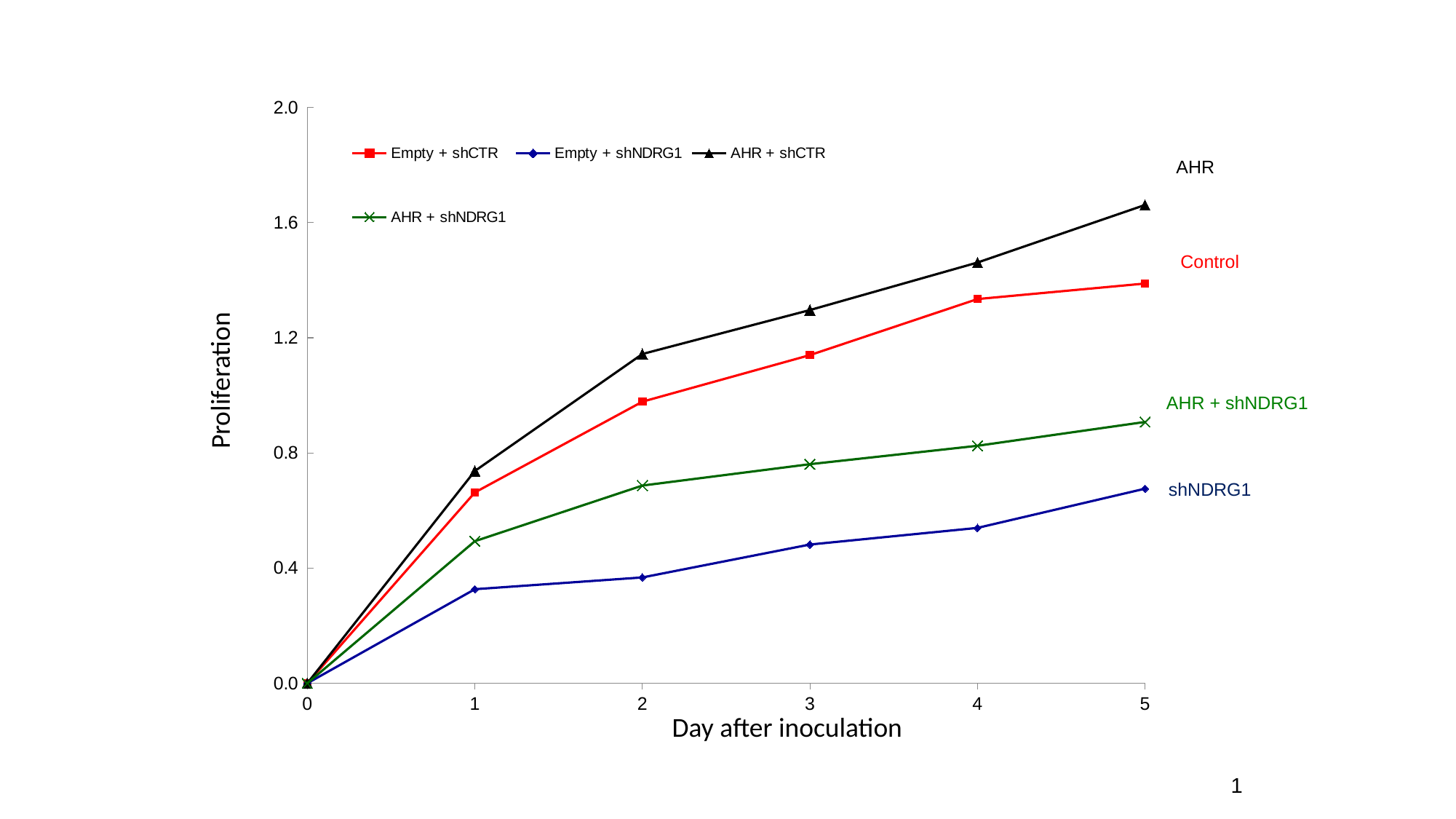
What kind of chart is shown on the slide? line chart Is the value for AHR + shNDRG1 at day 5 greater or less than 0.8? greater Which series has the lowest proliferation value at day 5? Empty + shNDRG1 How many data points are plotted for the AHR + shCTR series? 6 Is the value for AHR + shCTR at day 5 greater or less than 1.6? greater Is the value for Empty + shNDRG1 at day 5 greater or less than 0.8? less Which series has the highest proliferation value at day 5? AHR + shCTR How many series does the legend list? 4 What is the title of the x axis? Day after inoculation What is the proliferation value for Empty + shCTR at day 0? 0.0 Does the Empty + shNDRG1 series rise or fall from day 0 to day 5? rise At day 3, which is larger: the value for Empty + shCTR or the value for AHR + shNDRG1? Empty + shCTR